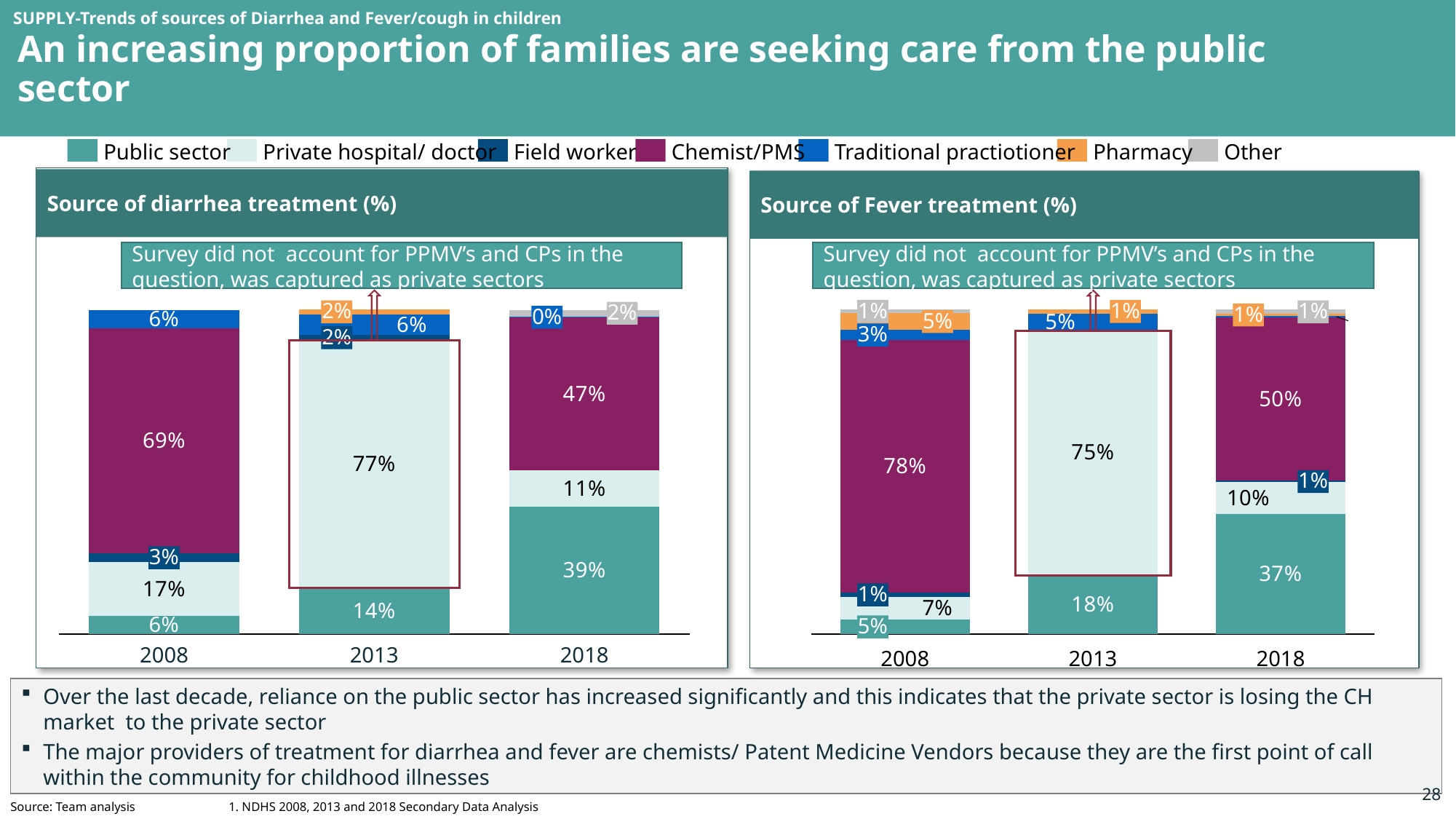
In the 'Source of diarrhea treatment (%)' chart, by how many percentage points did the Chemist/PMS share fall from 2008 to 2018? 22 percentage points What kind of chart is the 'Source of diarrhea treatment (%)' chart? Stacked bar chart In the 'Source of diarrhea treatment (%)' chart, which year has the highest Public sector value? 2018 How many series does the legend list for the charts on this slide? 7 In the 'Source of Fever treatment (%)' chart, by how many percentage points did the Public sector share rise from 2008 to 2018? 32 percentage points In the 'Source of diarrhea treatment (%)' chart, what is the Public sector value for 2018? 39% Which is larger for 2013: the Public sector value in the 'Source of Fever treatment (%)' chart or in the 'Source of diarrhea treatment (%)' chart? Source of Fever treatment (%) In the 'Source of Fever treatment (%)' chart, what is the Chemist/PMS value for 2008? 78% How many years are shown on the x axis of the 'Source of Fever treatment (%)' chart? 3 In the 'Source of Fever treatment (%)' chart, what is the Private hospital/ doctor value for 2018? 10% In the 'Source of diarrhea treatment (%)' chart, what is the Private hospital/ doctor value for 2013? 77% In the 'Source of Fever treatment (%)' chart, does the Public sector share rise or fall from 2008 to 2018? Rises